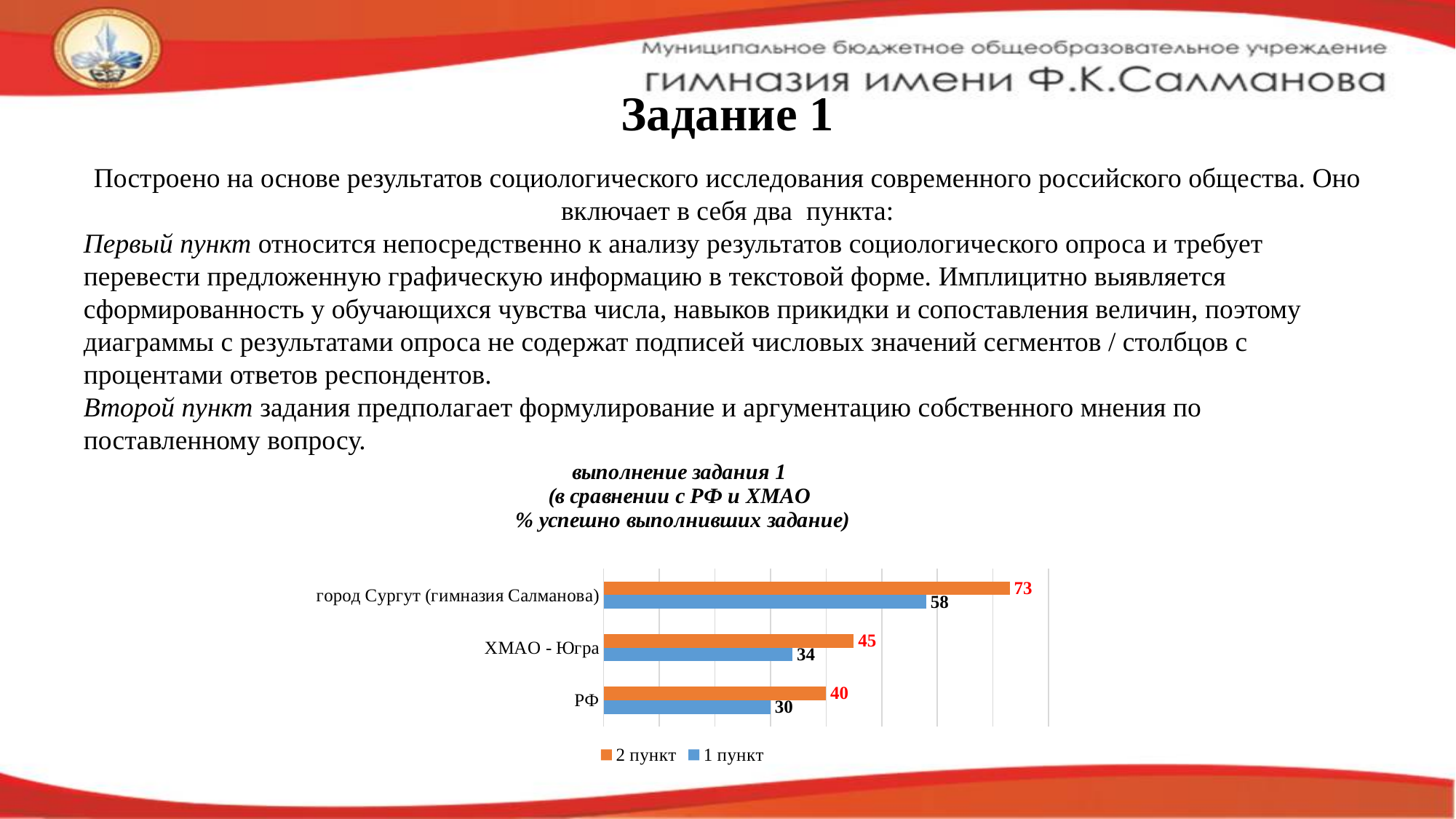
Which is larger: the '2 пункт' value for ХМАО - Югра or the '2 пункт' value for РФ? ХМАО - Югра What is the value for '1 пункт' for ХМАО - Югра? 34 Which colour represents the '2 пункт' series? orange Which category has the lowest value for '2 пункт'? РФ What is the value for '1 пункт' for РФ? 30 What kind of chart is shown on the slide? bar chart How many series does the legend list? 2 What is the value for '2 пункт' for ХМАО - Югра? 45 How many categories are shown on the chart? 3 What is the difference between the '2 пункт' and '1 пункт' values for город Сургут (гимназия Салманова)? 15 What is the value for '2 пункт' for город Сургут (гимназия Салманова)? 73 Which category has the highest value for '1 пункт'? город Сургут (гимназия Салманова)